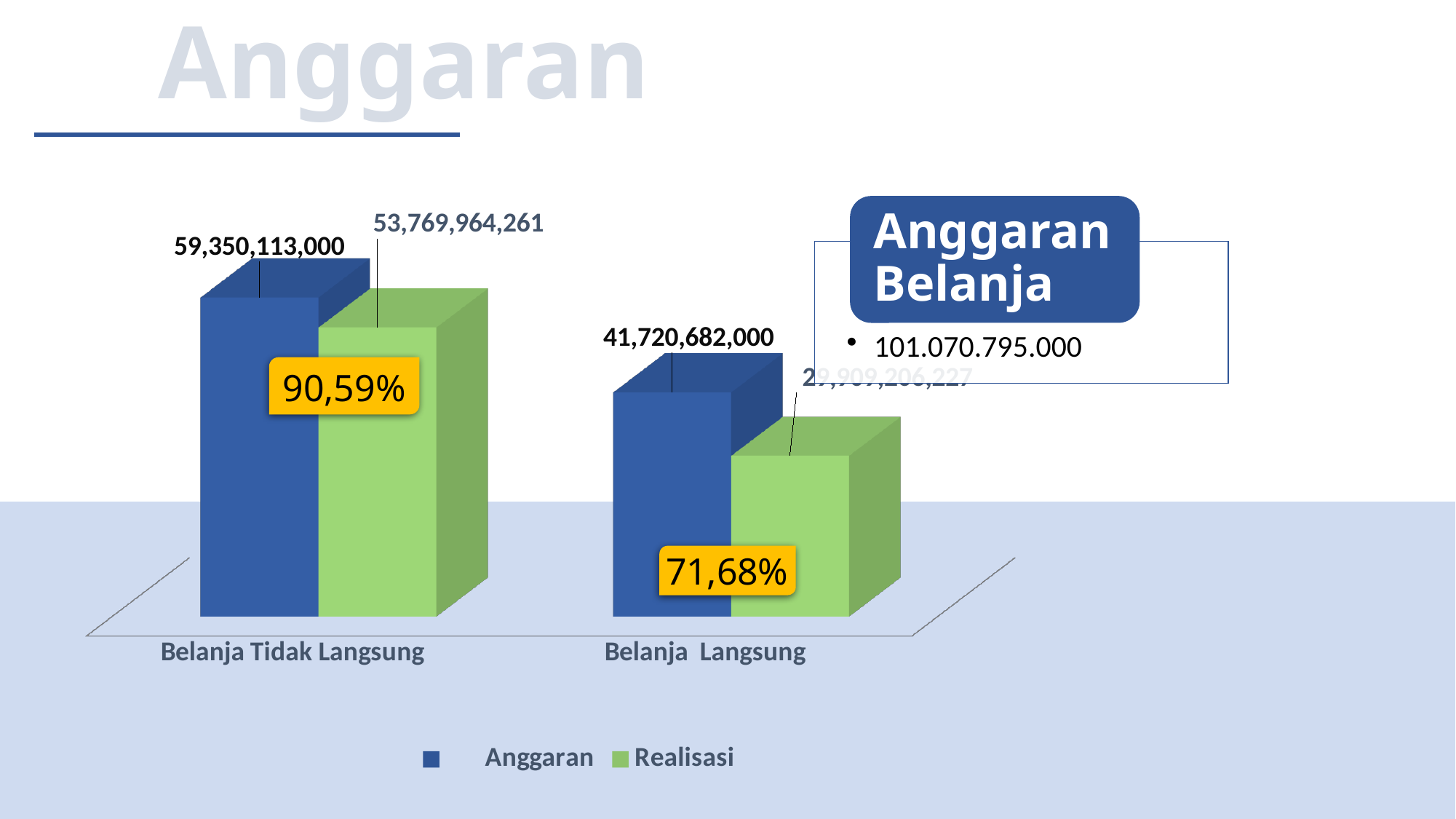
What is the Realisasi value for Belanja Tidak Langsung? 53,769,964,261 What type of chart is shown on the slide? Bar chart Which bar in the chart is the shortest? Realisasi for Belanja Langsung How many series does the chart legend list? 2 What is the Anggaran value for Belanja Tidak Langsung? 59,350,113,000 Which category has the higher Anggaran value, Belanja Tidak Langsung or Belanja Langsung? Belanja Tidak Langsung What is the difference between Anggaran and Realisasi for Belanja Tidak Langsung? 5,580,148,739 Which bar in the chart is the tallest? Anggaran for Belanja Tidak Langsung For Belanja Langsung, which is larger, Anggaran or Realisasi? Anggaran How much larger is the Anggaran for Belanja Tidak Langsung than the Anggaran for Belanja Langsung? 17,629,431,000 What is the Anggaran value for Belanja Langsung? 41,720,682,000 How many categories are shown on the x axis of the chart? 2